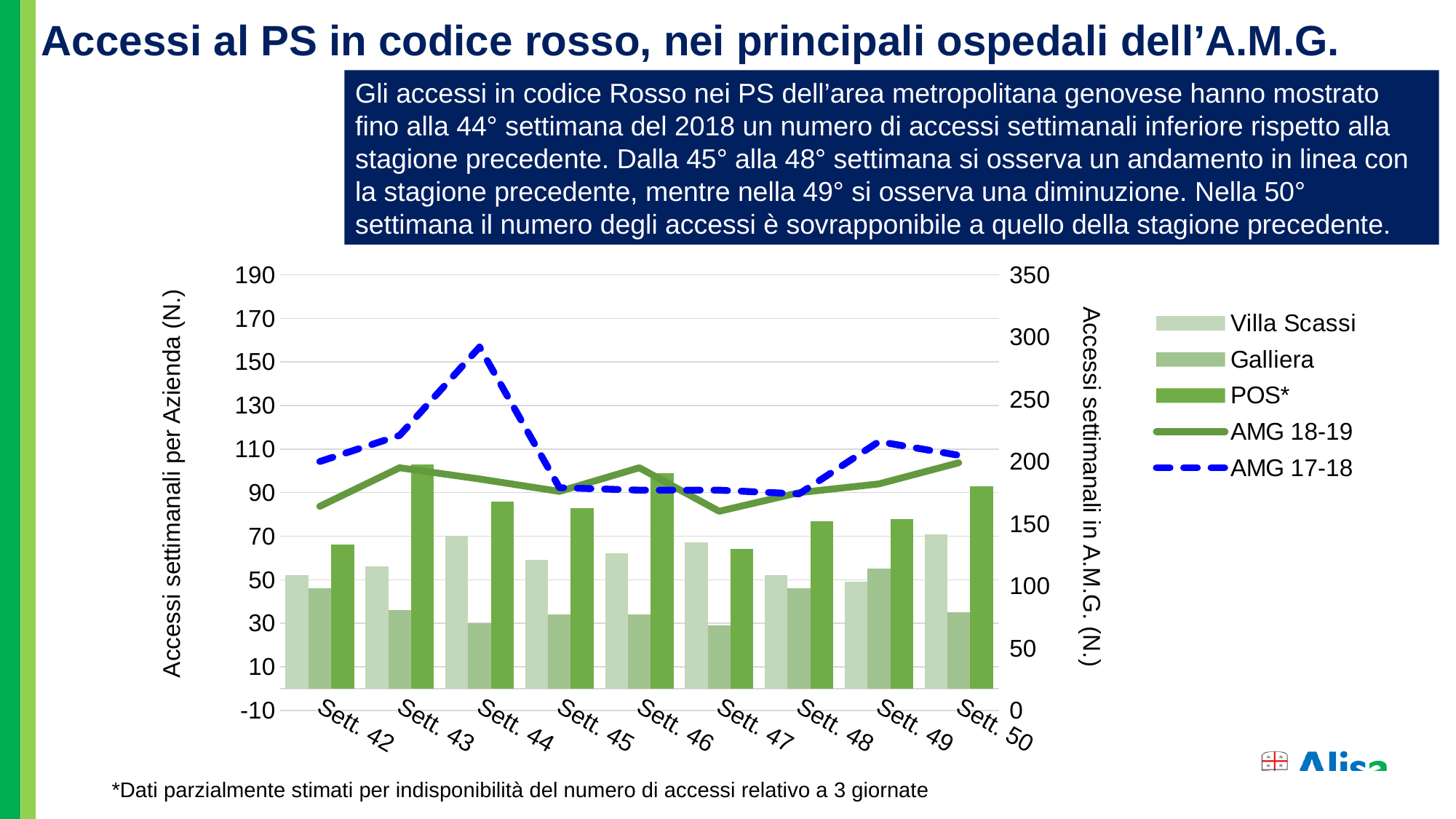
Is the Galliera value for Sett. 44 greater or less than 50? less Is the POS* value for Sett. 43 greater or less than 90? greater How many series does the chart legend list? 5 At Sett. 44, which is larger: the AMG 17-18 value or the AMG 18-19 value? AMG 17-18 Does the AMG 17-18 line rise or fall from Sett. 44 to Sett. 45? fall Which series is drawn as a dashed blue line? AMG 17-18 In which week does the AMG 17-18 line reach its highest value? Sett. 44 What is the title of the left vertical axis? Accessi settimanali per Azienda (N.) Is the AMG 17-18 value for Sett. 44 greater or less than 250 on the right axis? greater In which week is the Galliera bar the highest? Sett. 49 What kind of chart is shown on the slide? Combined bar and line chart How many weeks (categories) are shown on the x axis of the chart? 9